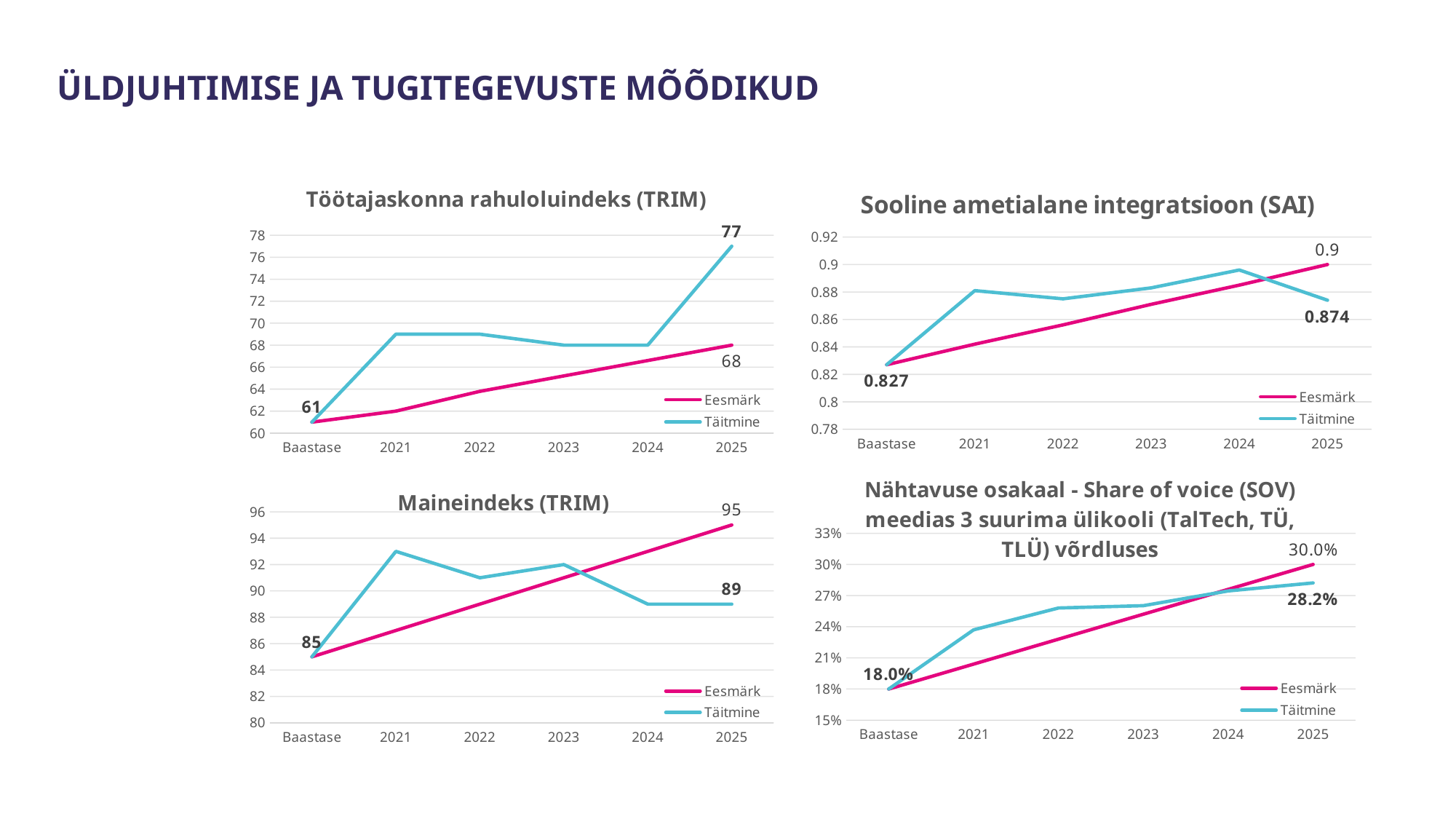
In the 'Maineindeks (TRIM)' chart, what is the Täitmine value for 2025? 89 In the 'Töötajaskonna rahuloluindeks (TRIM)' chart, what is the difference between the Täitmine and Eesmärk values for 2025? 9 How many series does the legend of the 'Maineindeks (TRIM)' chart list? 2 In the 'Sooline ametialane integratsioon (SAI)' chart, which is larger for 2025, Eesmärk or Täitmine? Eesmärk In the 'Nähtavuse osakaal - Share of voice (SOV)' chart, what is the Baastase value? 18.0% In the 'Sooline ametialane integratsioon (SAI)' chart, what is the Baastase value? 0.827 In the 'Töötajaskonna rahuloluindeks (TRIM)' chart, what is the Täitmine value for 2025? 77 In the 'Nähtavuse osakaal - Share of voice (SOV)' chart, what is the Täitmine value for 2025? 28.2% In the 'Maineindeks (TRIM)' chart, what is the difference between the Eesmärk value for 2025 and the Baastase value? 10 In the 'Maineindeks (TRIM)' chart, is the Täitmine value for 2021 greater or less than 92? greater What kind of chart is the 'Sooline ametialane integratsioon (SAI)' chart? Line chart In the 'Töötajaskonna rahuloluindeks (TRIM)' chart, what is the Eesmärk value for 2025? 68